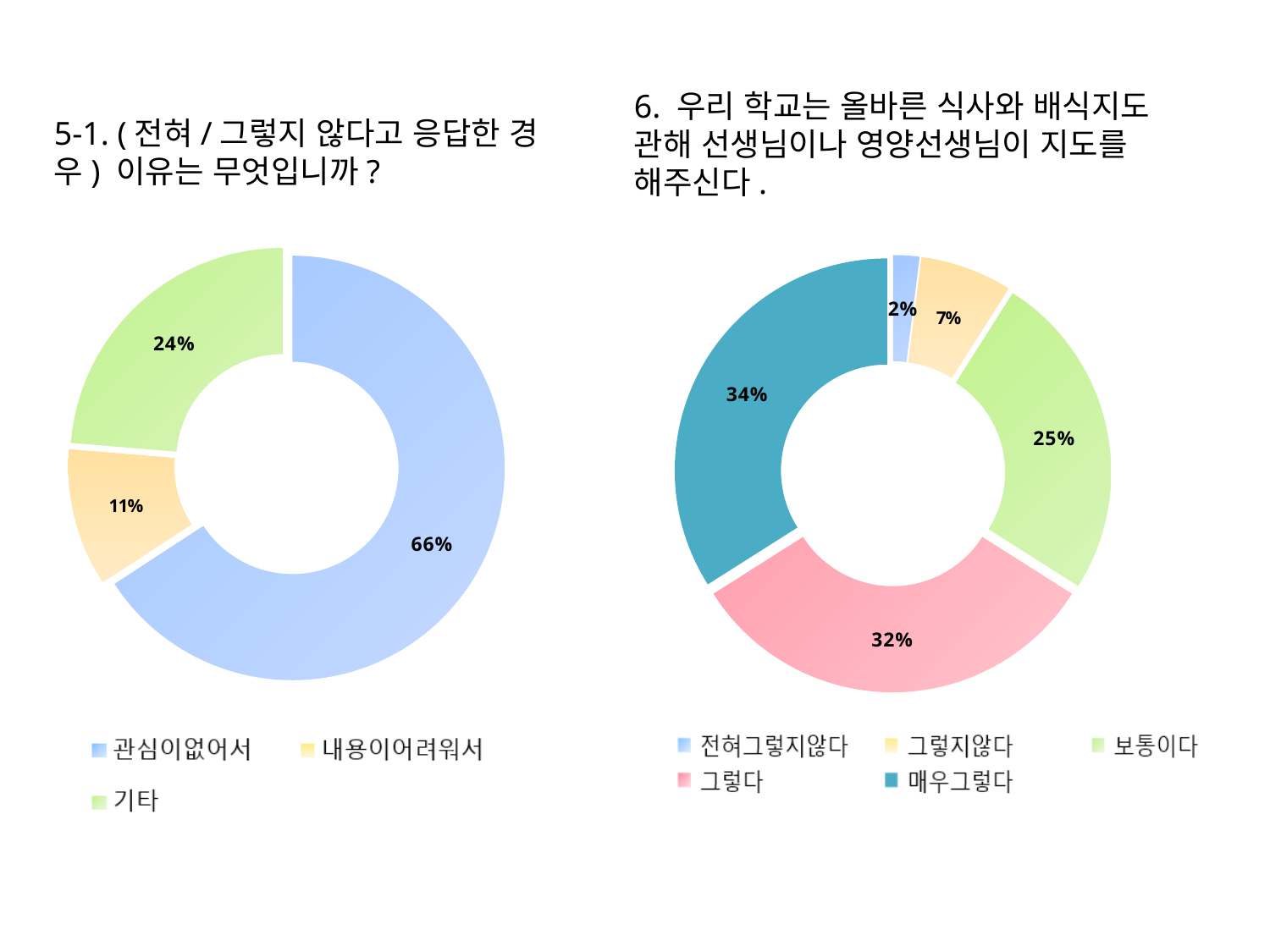
In the right chart (6), what is the difference between the shares for 매우그렇다 and 그렇다? 2% What kind of chart is the left chart (5-1)? Doughnut chart In the left chart (5-1), what percentage is shown for 관심이없어서? 66% In the left chart (5-1), how many categories does the legend list? 3 In the left chart (5-1), what percentage is shown for 기타? 24% In the right chart (6), what percentage is shown for 매우그렇다? 34% In the right chart (6), which category has the smallest share? 전혀그렇지않다 In the right chart (6), how many categories does the legend list? 5 In the right chart (6), what percentage is shown for 그렇지않다? 7% In the left chart (5-1), which category has the smallest share? 내용이어려워서 In the right chart (6), which is larger, the share for 보통이다 or the share for 그렇지않다? 보통이다 In the left chart (5-1), what is the difference between the shares for 관심이없어서 and 기타? 42%